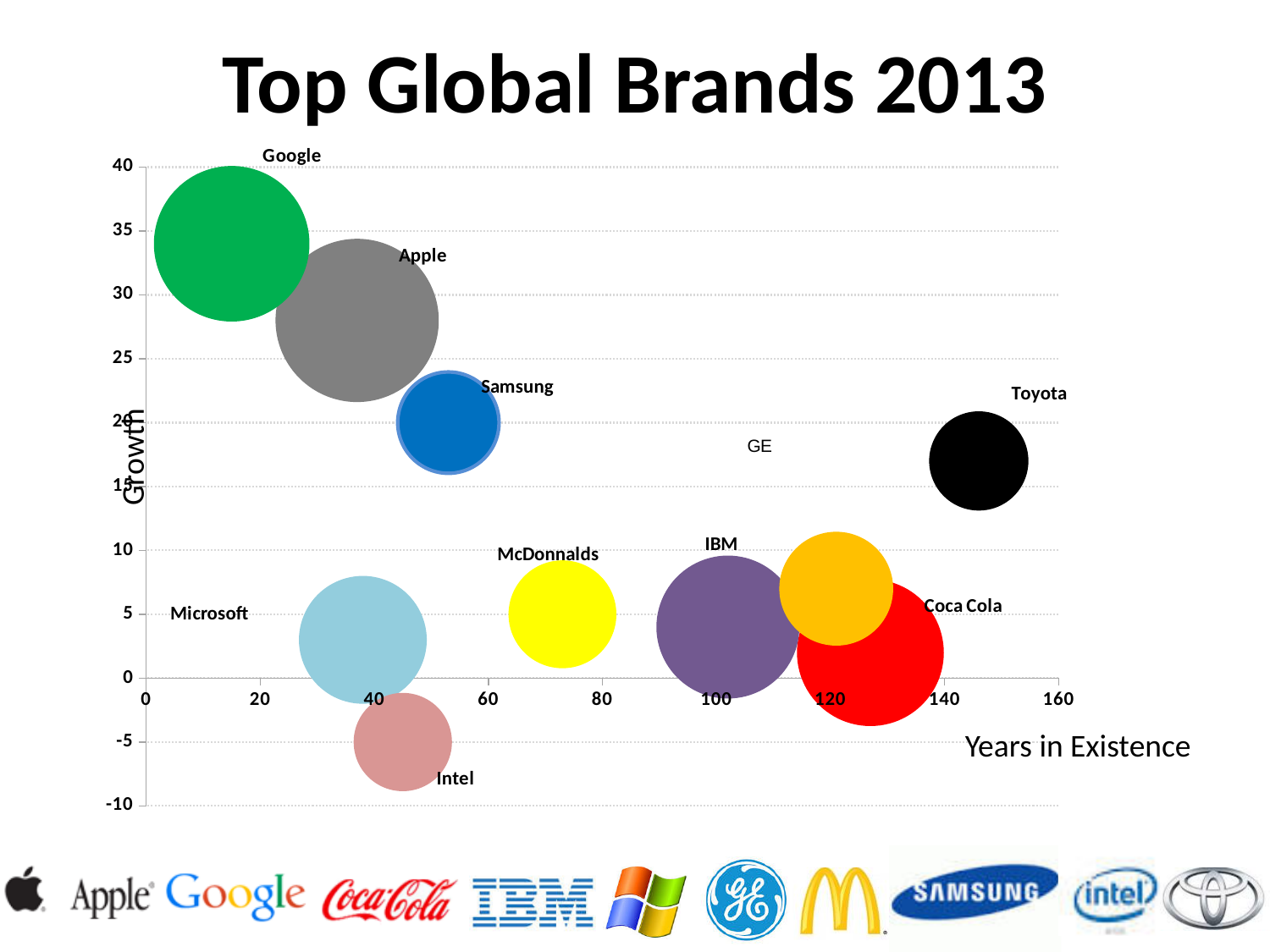
Is the years-in-existence value for Toyota greater or less than 140? greater What kind of chart is shown on the slide? Bubble chart Is the growth value for McDonnalds greater or less than 10? less Which brand has the most years in existence on the chart? Toyota Which brand has the fewest years in existence on the chart? Google Which brand has the lowest growth value on the chart? Intel What is the label of the horizontal axis of the chart? Years in Existence Is the growth value for Intel greater or less than 0? less Which brand has a higher growth value, Apple or Samsung? Apple How many brands are plotted on the chart? 10 Which brand has the highest growth value on the chart? Google